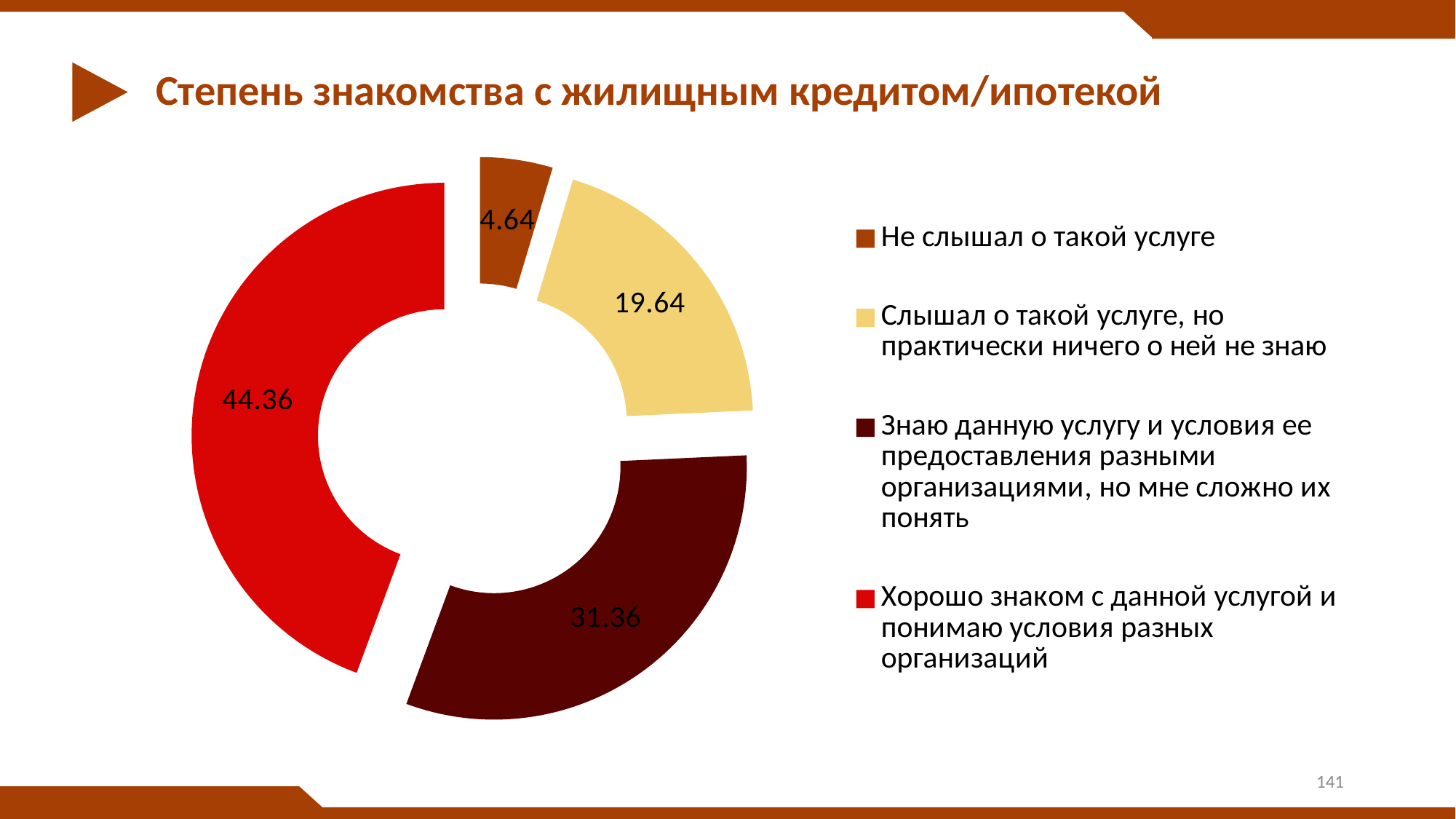
Which is larger: the value for "Слышал о такой услуге, но практически ничего о ней не знаю" or for "Не слышал о такой услуге"? Слышал о такой услуге, но практически ничего о ней не знаю What is the title of the slide? Степень знакомства с жилищным кредитом/ипотекой What value is shown for the slice "Хорошо знаком с данной услугой и понимаю условия разных организаций"? 44.36 What value is shown for the slice "Не слышал о такой услуге"? 4.64 Which category has the smallest slice? Не слышал о такой услуге What is the difference between the values for "Хорошо знаком с данной услугой и понимаю условия разных организаций" and "Знаю данную услугу и условия ее предоставления разными организациями, но мне сложно их понять"? 13 What colour is the slice for "Не слышал о такой услуге"? Brown (orange-brown) What value is shown for the slice "Знаю данную услугу и условия ее предоставления разными организациями, но мне сложно их понять"? 31.36 How many categories does the chart show? 4 Which category has the largest slice? Хорошо знаком с данной услугой и понимаю условия разных организаций What value is shown for the slice "Слышал о такой услуге, но практически ничего о ней не знаю"? 19.64 What kind of chart is shown on the slide? Doughnut (pie) chart